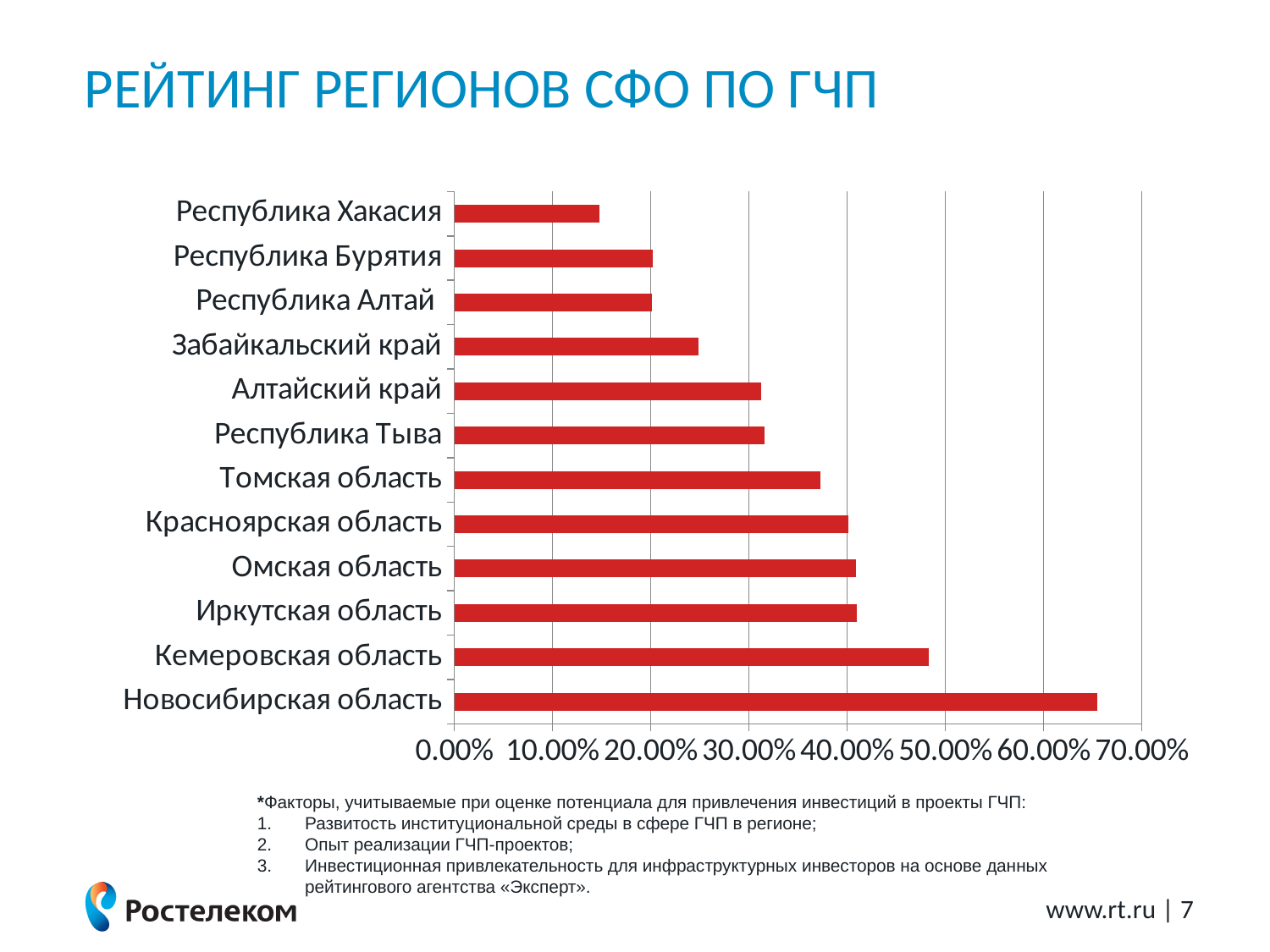
Is the value for Кемеровская область greater or less than 50.00%? less Is the value for Томская область greater or less than 40.00%? less Is the value for Республика Хакасия greater or less than 10.00%? greater Which region has the highest value in the chart? Новосибирская область Which has a larger value, Кемеровская область or Томская область? Кемеровская область What kind of chart is shown on the slide? bar chart Which has a larger value, Республика Тыва or Республика Бурятия? Республика Тыва Which region has the lowest value in the chart? Республика Хакасия How many regions are plotted in the chart? 12 What is the title of the slide containing the chart? РЕЙТИНГ РЕГИОНОВ СФО ПО ГЧП